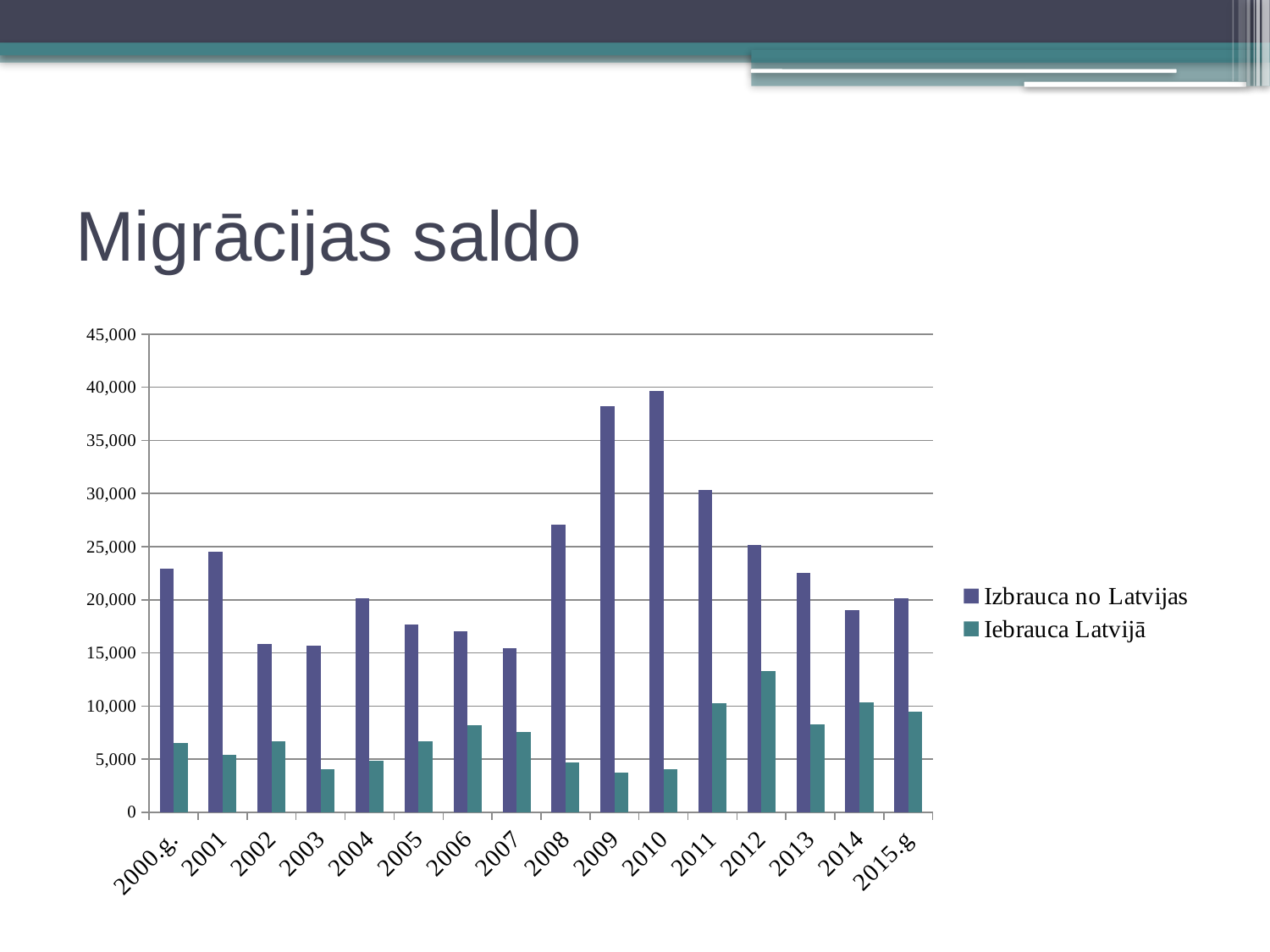
How many year categories are shown on the x axis? 16 What kind of chart is shown on the slide? bar chart Is the value for Izbrauca no Latvijas in 2009 greater or less than 35,000? greater How many series does the legend list? 2 Does the value for Izbrauca no Latvijas rise or fall from 2010 to 2014? fall Is the value for Izbrauca no Latvijas in 2008 greater or less than 25,000? greater What is the title of the chart on the slide? Migrācijas saldo In which year is the value for Iebrauca Latvijā highest? 2012 In which year is the value for Izbrauca no Latvijas highest? 2010 Is the value for Izbrauca no Latvijas in 2002 greater or less than 20,000? less Which is larger for Izbrauca no Latvijas: the value in 2008 or the value in 2009? 2009